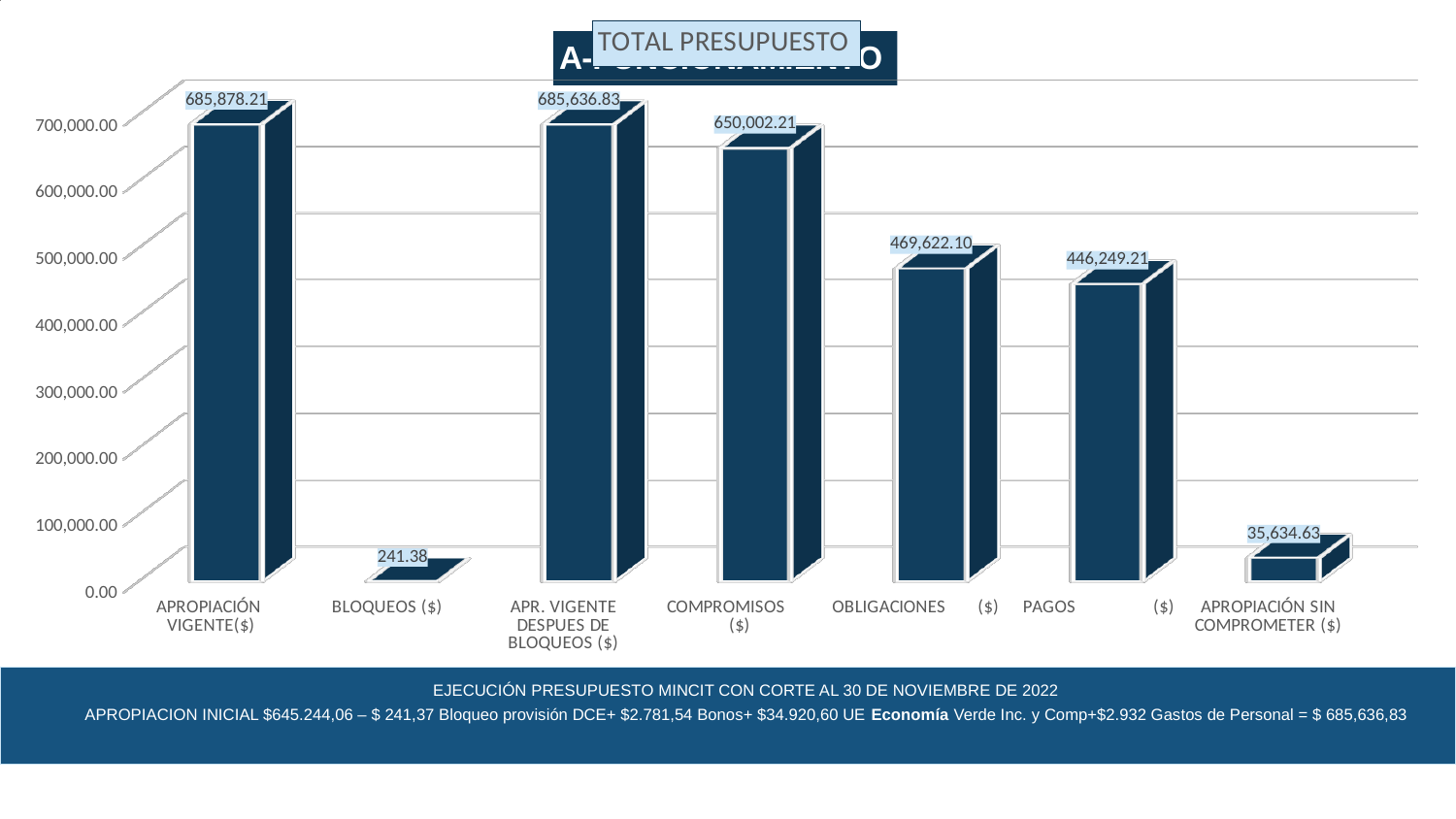
What is the value for APROPIACIÓN VIGENTE($)? 685,878.21 What is the value for APROPIACIÓN SIN COMPROMETER ($)? 35,634.63 What is the value for COMPROMISOS ($)? 650,002.21 What is the difference between COMPROMISOS ($) and OBLIGACIONES ($)? 180,380.11 Which is larger, the value for COMPROMISOS ($) or the value for OBLIGACIONES ($)? COMPROMISOS ($) What kind of chart is shown on the slide? Bar chart Which category has the lowest value? BLOQUEOS ($) Is the value for PAGOS ($) greater or less than 500,000.00? less Is the value for COMPROMISOS ($) greater or less than 600,000.00? greater What is the difference between OBLIGACIONES ($) and PAGOS ($)? 23,372.89 How many categories are shown on the x axis? 7 What is the value for PAGOS ($)? 446,249.21